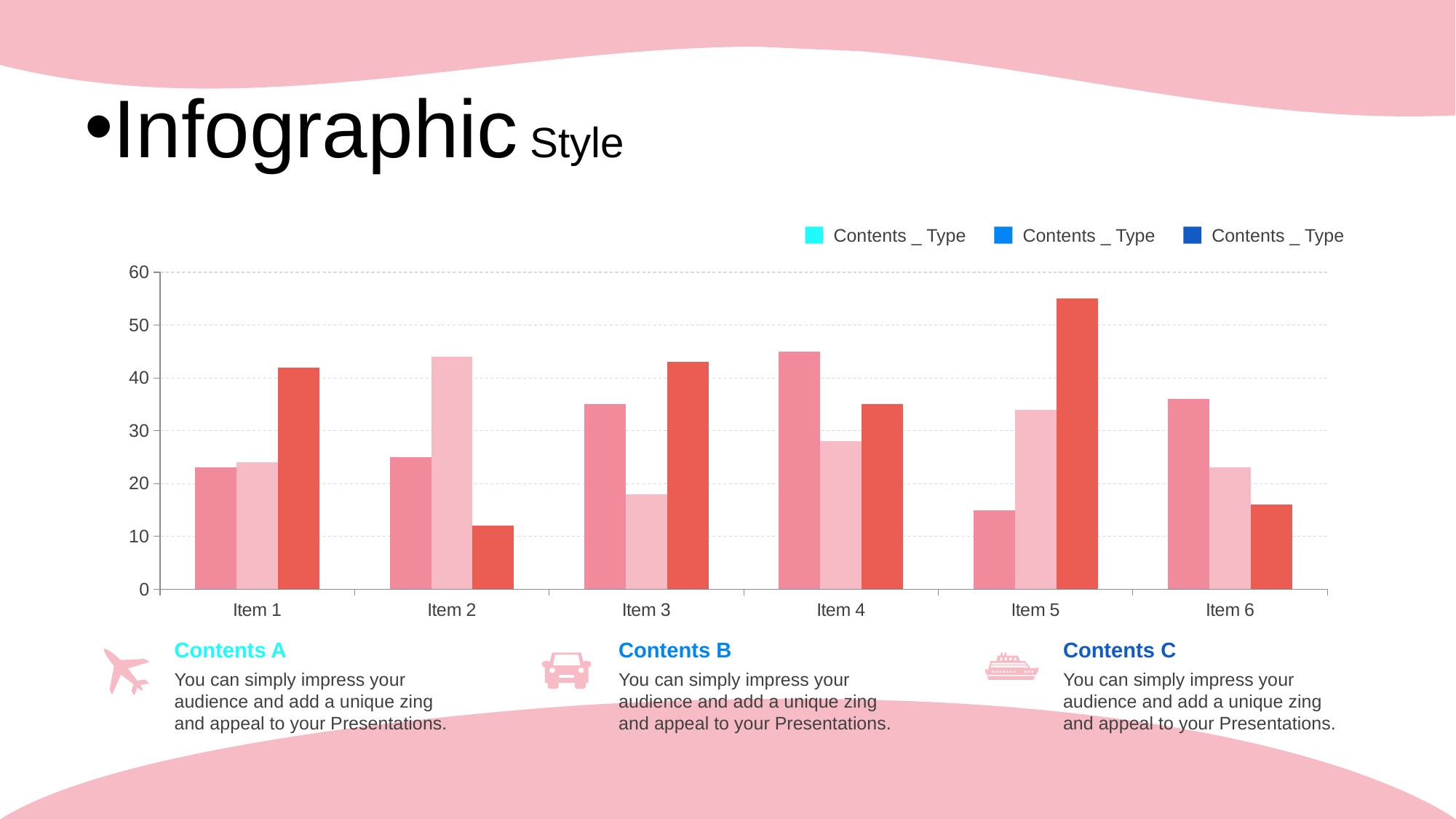
How many categories are shown on the x axis of the chart? 6 What kind of chart is shown on the slide? bar chart Is the shortest bar for Item 2 greater or less than 20? less Is the shortest bar for Item 5 greater or less than 20? less What text is used for each of the legend entries in the chart? Contents _ Type Which category contains the tallest bar in the chart? Item 5 What is the highest value shown on the chart's y axis? 60 Which category contains the shortest bar in the chart? Item 2 How many series does the chart's legend list? 3 Is the tallest bar for Item 4 greater or less than 40? greater